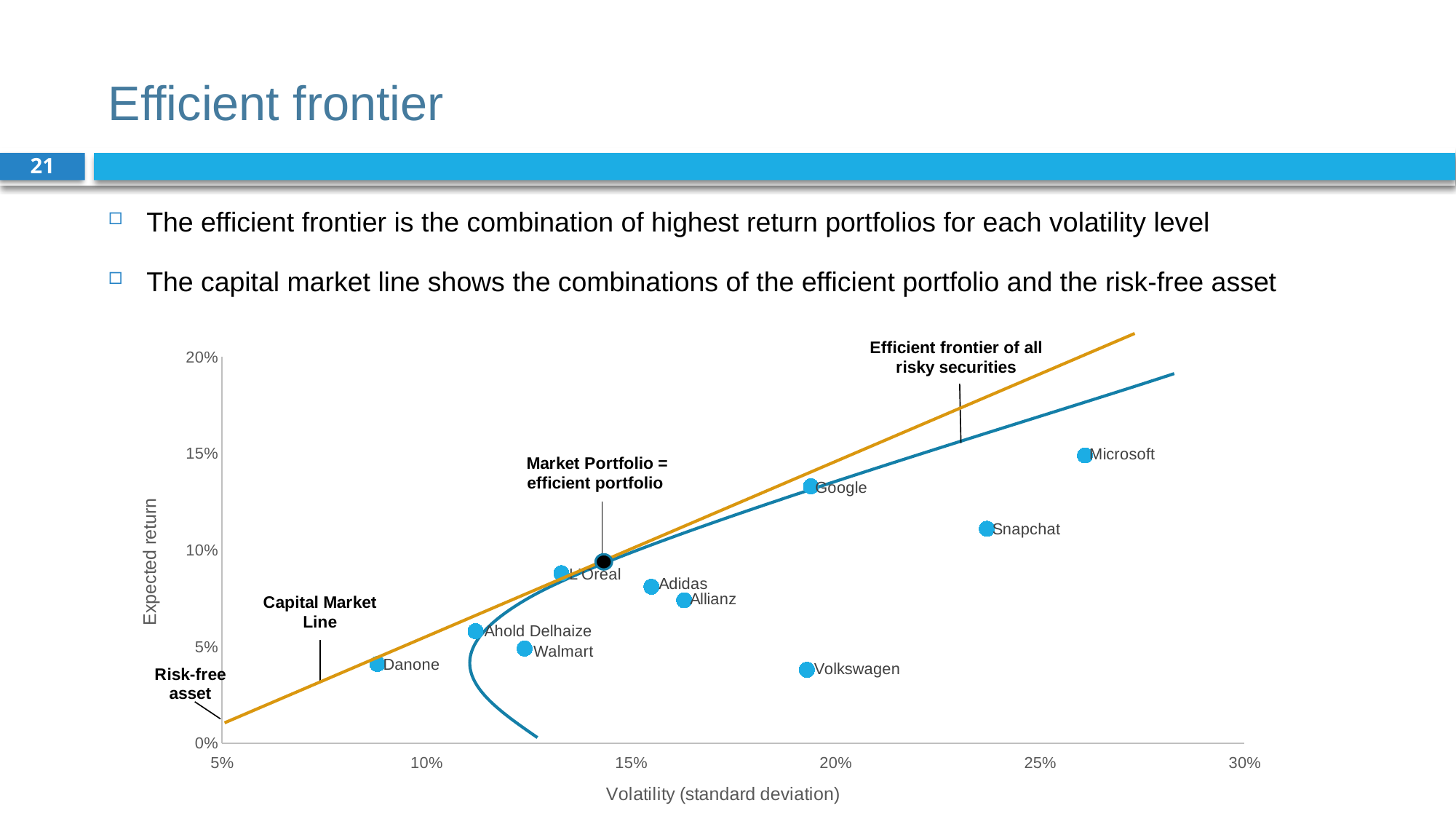
Which company has the highest expected return? Microsoft How many named companies are plotted on the chart? 10 Which has the higher volatility, Snapchat or Google? Snapchat Which company has the highest volatility? Microsoft Is the expected return for Volkswagen greater or less than 5%? less Which has the higher expected return, Google or Snapchat? Google Which company has the lowest expected return? Volkswagen Is the volatility for Microsoft greater or less than 25%? greater Which company has the lowest volatility? Danone Is the expected return for Google greater or less than 10%? greater What kind of chart is shown on the slide? scatter chart What is the title of the x axis? Volatility (standard deviation)